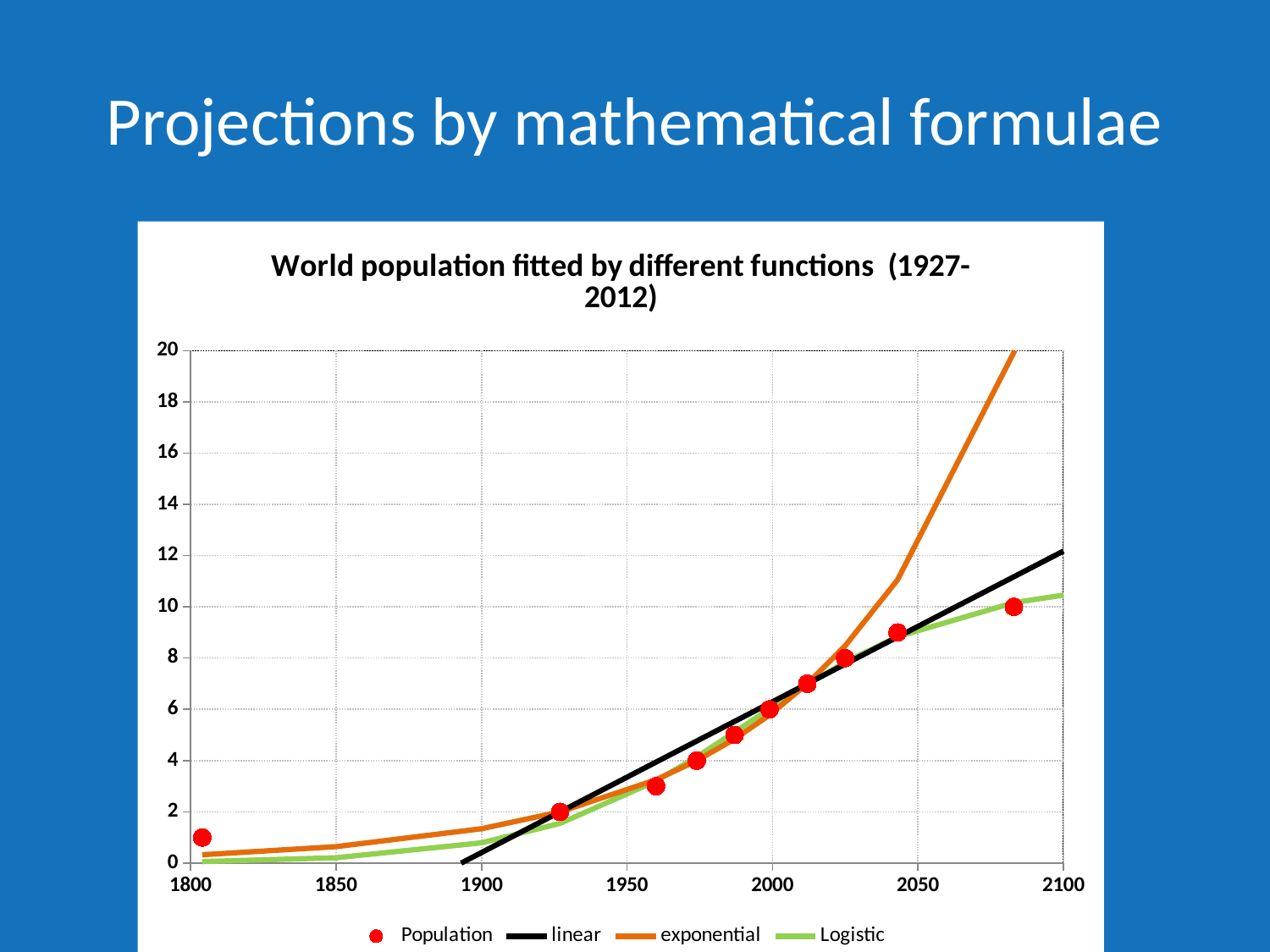
Do the Population values rise or fall as the year increases along the x axis? rise Which series reaches the highest value at the right edge of the chart (2100)? exponential What kind of chart is this? line chart Is the value of the Logistic curve at 2100 greater or less than 12? less Is the value of the linear line at 1900 greater or less than 2? less What colour is the exponential series drawn in? orange How many series does the legend list? 4 At 1850, which is larger: the exponential curve or the Logistic curve? exponential Which fitted curve is lowest at 2100? Logistic How many red Population data points are plotted? 10 What is the title of the chart? World population fitted by different functions (1927-2012) Is the value of the exponential curve at 2050 greater or less than 10? greater